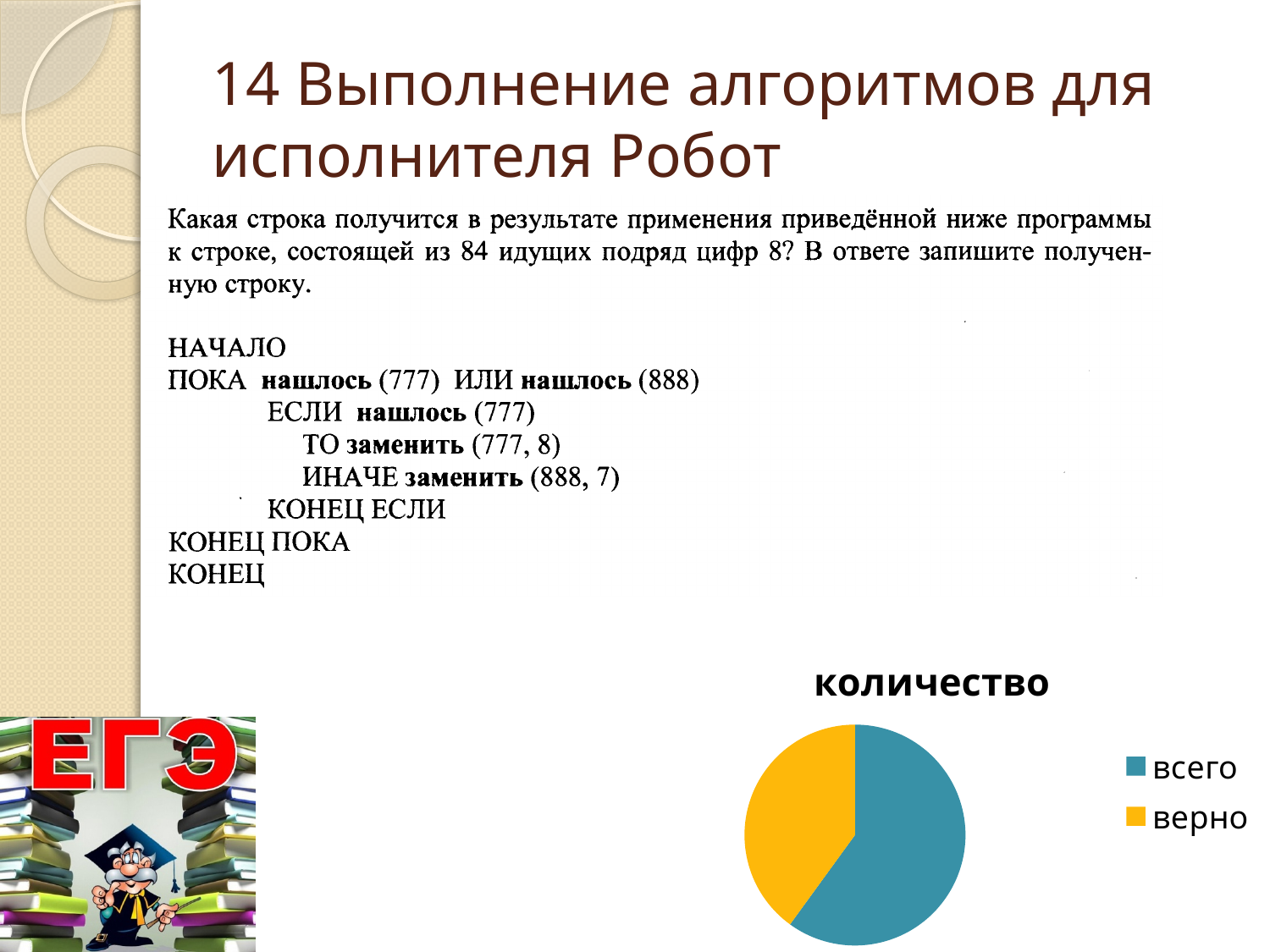
What is the title of the pie chart? количество How many slices does the pie chart have? 2 Which slice is larger in the pie chart, всего or верно? всего What colour is the slice for верно in the pie chart? yellow What kind of chart is shown on the slide? pie chart Which category has the smallest slice in the pie chart? верно Which category has the largest slice in the pie chart? всего How many entries does the legend of the pie chart list? 2